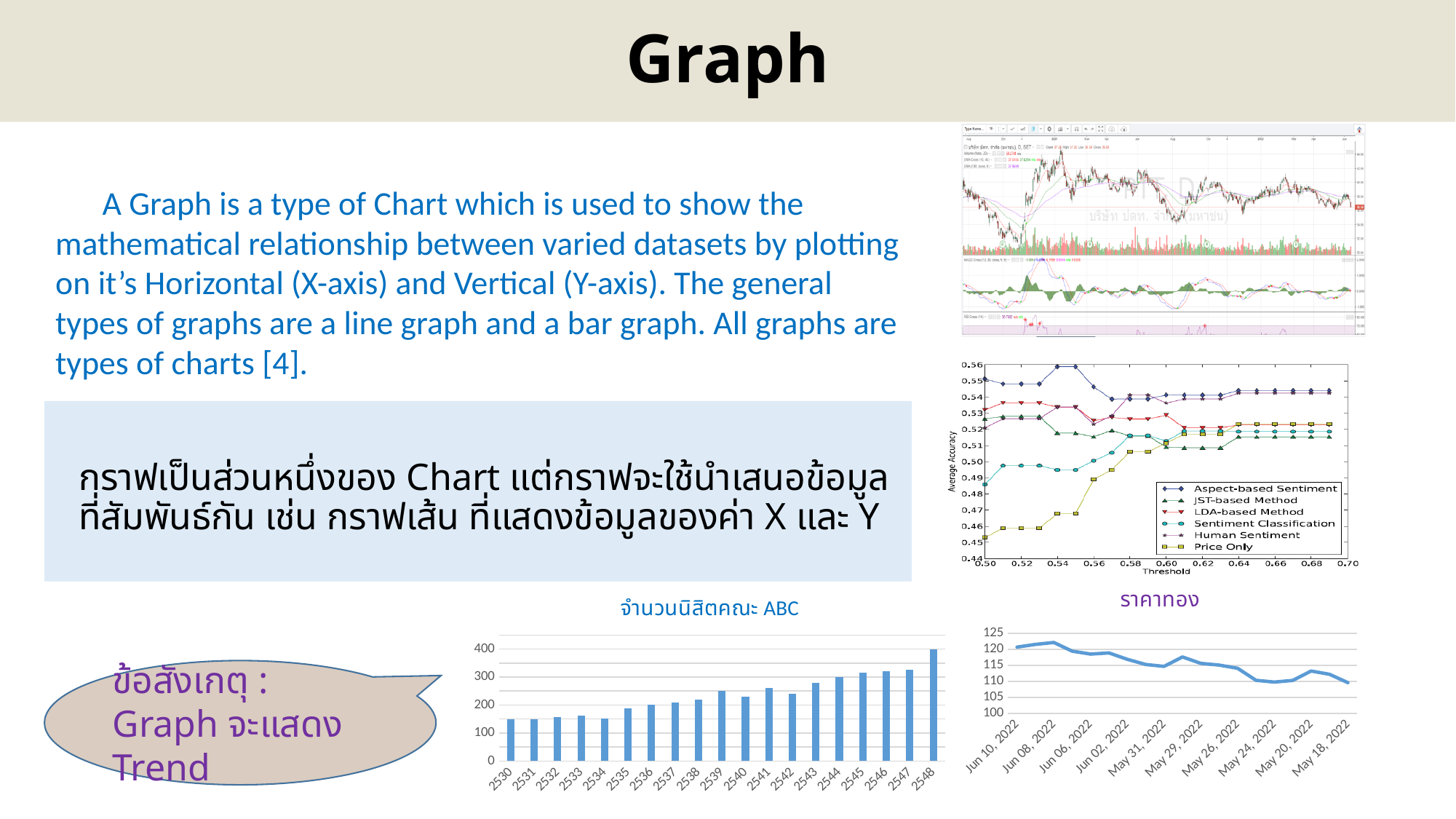
In the chart titled จำนวนนิสิตคณะ ABC, do the values generally rise or fall from 2530 to 2548? rise In the chart titled จำนวนนิสิตคณะ ABC, how many categories (years) are shown on the x axis? 19 In the chart titled จำนวนนิสิตคณะ ABC, is the value for 2530 greater or less than 200? less In the chart titled จำนวนนิสิตคณะ ABC, is the value for 2548 greater or less than 300? greater What type of chart is the chart titled ราคาทอง? line chart What type of chart is the chart titled จำนวนนิสิตคณะ ABC? bar chart In the chart titled ราคาทอง, is the value for Jun 10, 2022 greater or less than 115? greater In the Average Accuracy vs Threshold line chart on the right, which series has the lowest value at threshold 0.50? Price Only In the chart titled ราคาทอง, which is larger, the value for Jun 10, 2022 or the value for May 18, 2022? Jun 10, 2022 In the Average Accuracy vs Threshold line chart on the right, how many series does the legend list? 6 In the chart titled ราคาทอง, which date has the highest value? Jun 08, 2022 In the chart titled จำนวนนิสิตคณะ ABC, which year has the highest bar? 2548